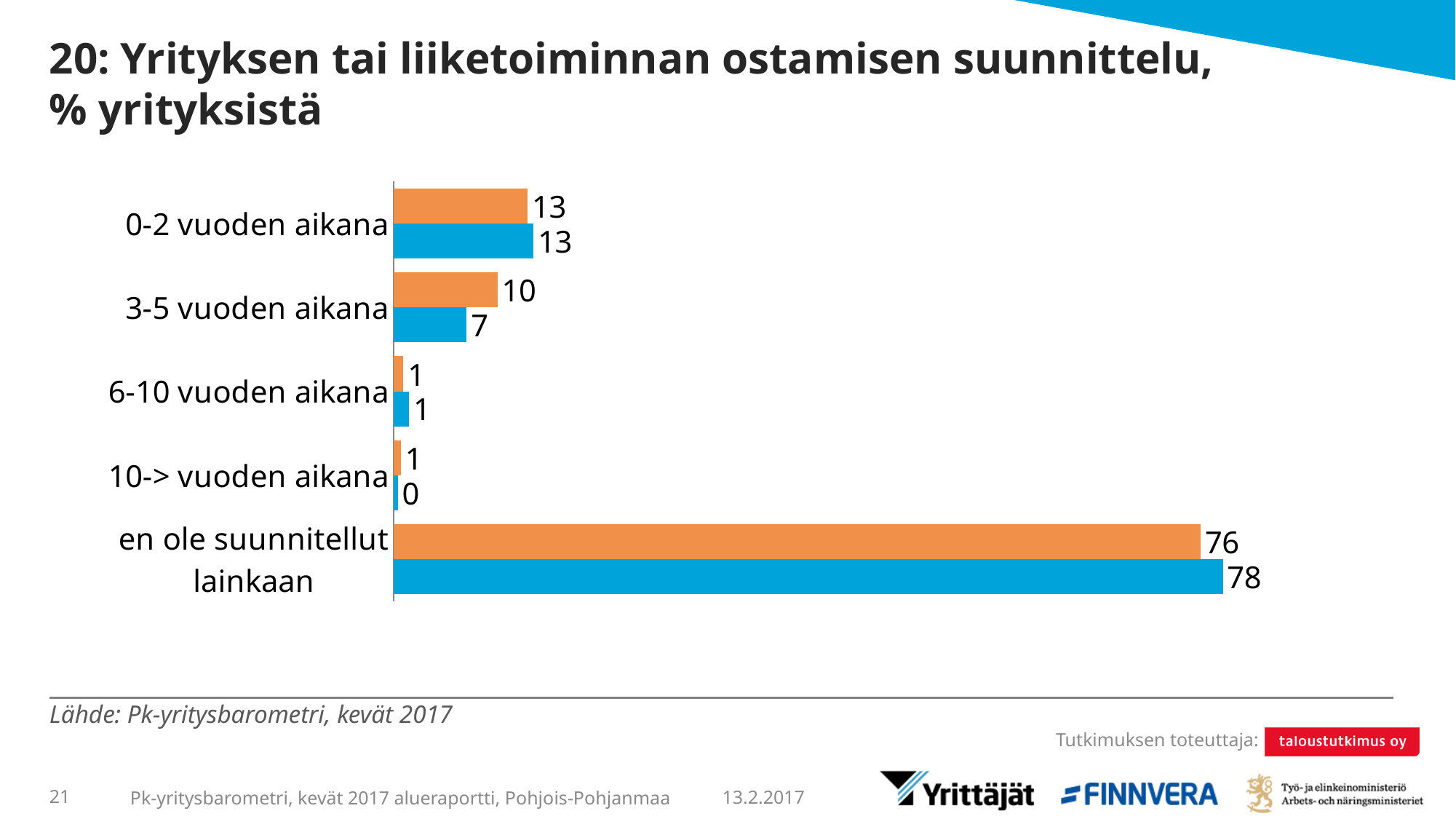
For "3-5 vuoden aikana", which bar is larger, the orange or the blue? orange What is the value of the orange bar for "0-2 vuoden aikana"? 13 Which category has the highest orange bar value? en ole suunnitellut lainkaan What is the difference between the blue and orange bar values for "en ole suunnitellut lainkaan"? 2 What is the value of the orange bar for "3-5 vuoden aikana"? 10 What kind of chart is shown on the slide? bar chart What is the value of the blue bar for "3-5 vuoden aikana"? 7 What is the value of the blue bar for "10-> vuoden aikana"? 0 Which category has the lowest blue bar value? 10-> vuoden aikana How many categories are shown on the chart? 5 What is the value of the blue bar for "en ole suunnitellut lainkaan"? 78 What is the title of the chart on the slide? 20: Yrityksen tai liiketoiminnan ostamisen suunnittelu, % yrityksistä